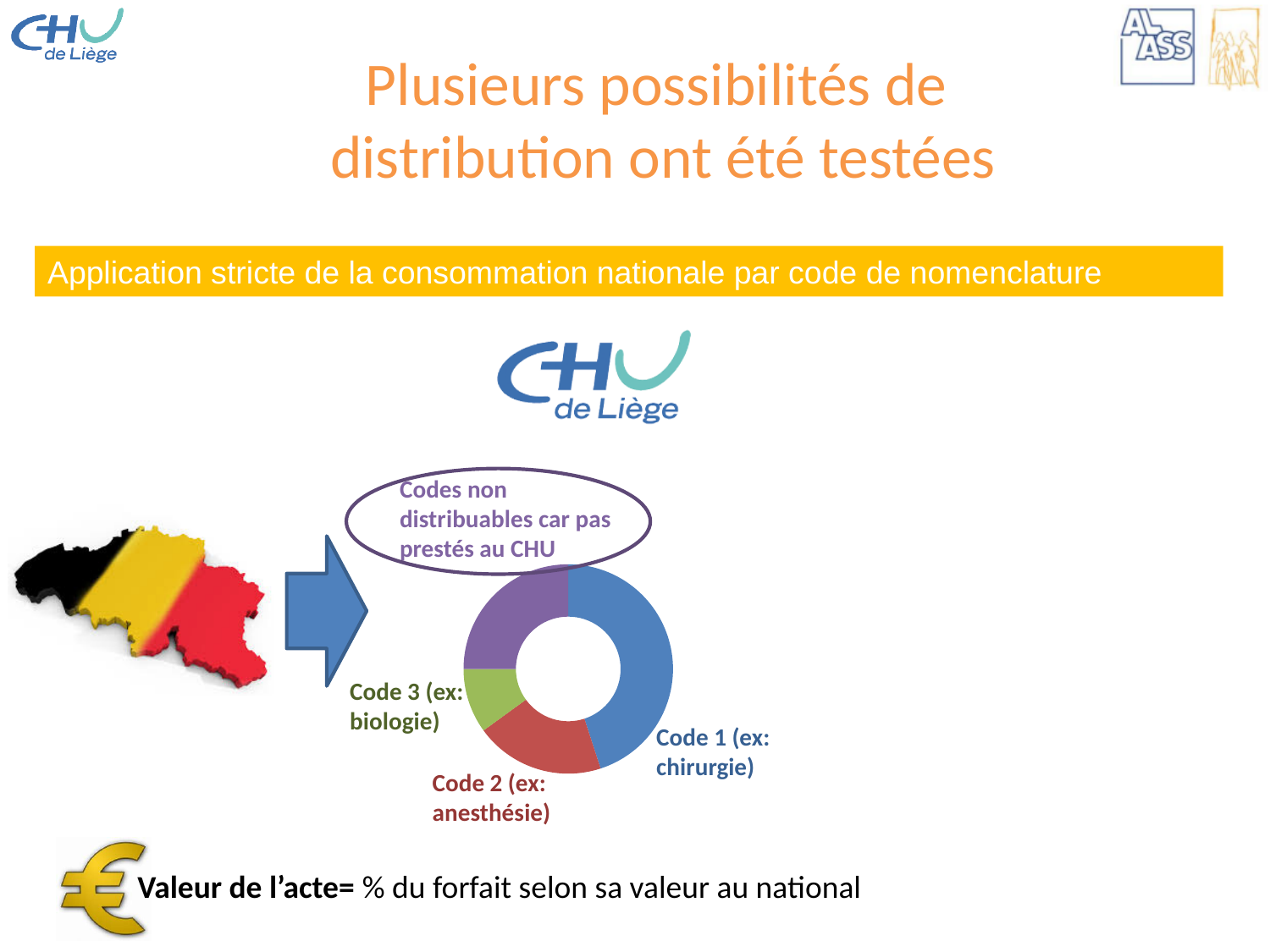
Which segment is larger in the doughnut chart, the 'Codes non distribuables car pas prestés au CHU' segment or Code 2 (ex: anesthésie)? Codes non distribuables car pas prestés au CHU What kind of chart is shown on the slide? doughnut chart What colour is the Code 1 (ex: chirurgie) segment of the doughnut chart? blue Which segment is larger in the doughnut chart, the 'Codes non distribuables car pas prestés au CHU' segment or Code 3 (ex: biologie)? Codes non distribuables car pas prestés au CHU Which segment is larger in the doughnut chart, Code 1 (ex: chirurgie) or Code 2 (ex: anesthésie)? Code 1 (ex: chirurgie) Which segment of the doughnut chart is the smallest? Code 3 (ex: biologie) Which segment of the doughnut chart is coloured purple? Codes non distribuables car pas prestés au CHU Which segment of the doughnut chart is the largest? Code 1 (ex: chirurgie) How many segments does the doughnut chart have? 4